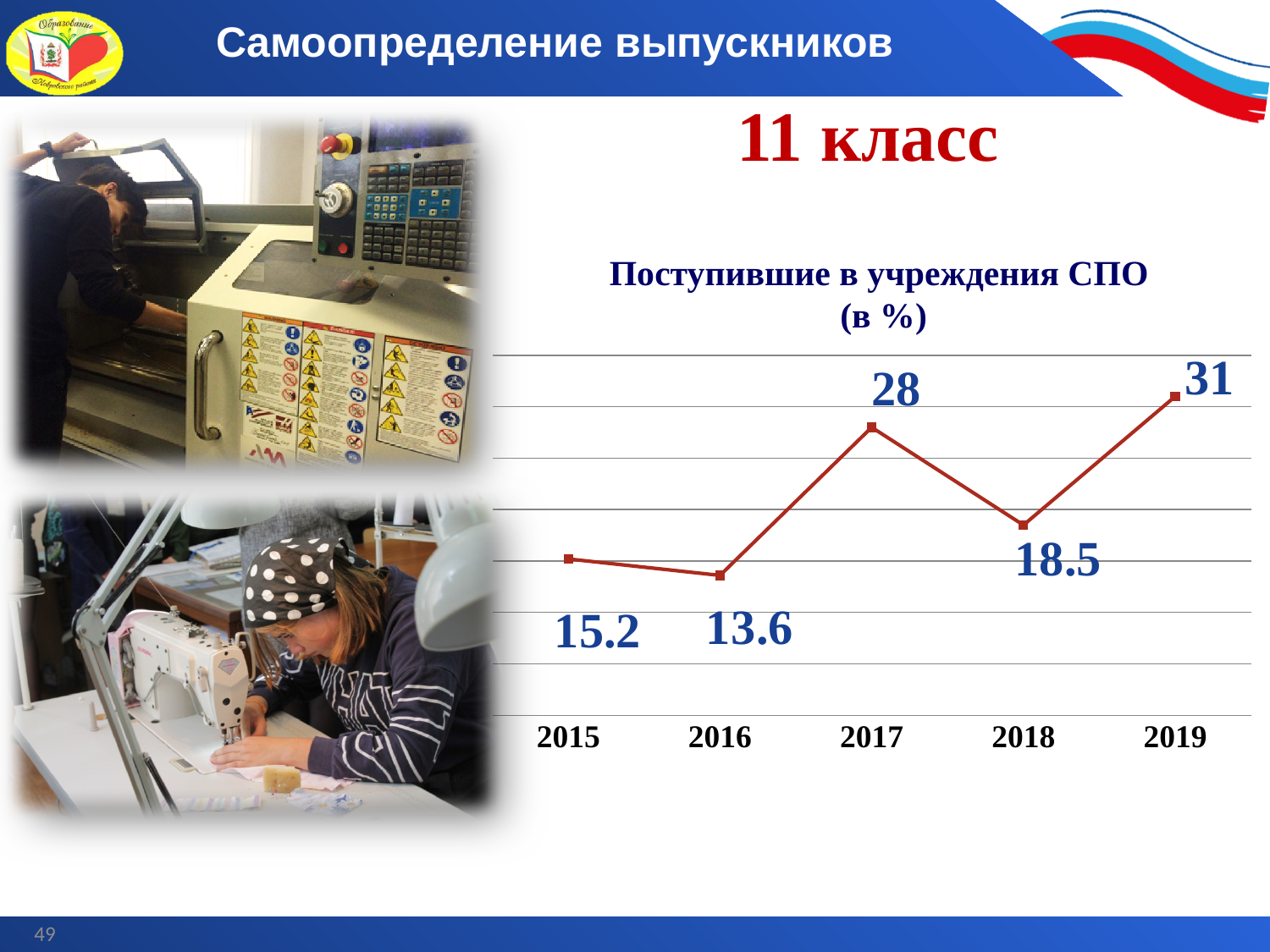
Which is larger, the value for 2015 or the value for 2016? 2015 What is the title of the chart on the slide? Поступившие в учреждения СПО (в %) What kind of chart is shown on the slide? line chart What value is shown for 2018 in the chart? 18.5 What value is shown for 2015 in the chart? 15.2 How many years are plotted on the x axis of the chart? 5 Which year has the lowest value in the chart? 2016 What is the difference between the values for 2017 and 2016? 14.4 Which year has the highest value in the chart? 2019 What value is shown for 2019 in the chart? 31 What value is shown for 2017 in the chart 'Поступившие в учреждения СПО (в %)'? 28 What is the difference between the values for 2019 and 2018? 12.5